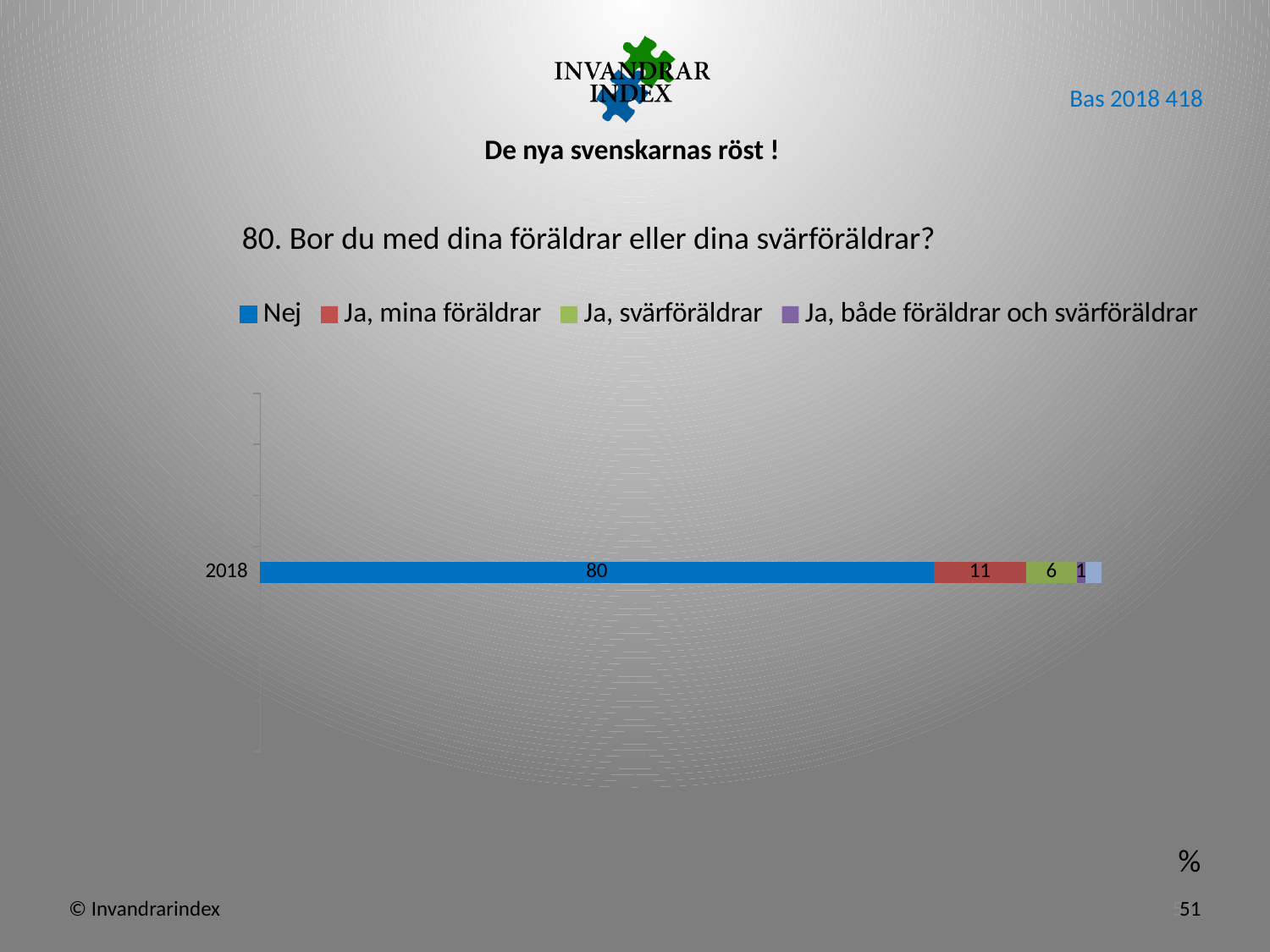
How many series does the legend list? 4 Which series has the highest value in 2018? Nej What is the value for "Ja, svärföräldrar" in 2018? 6 Which is larger in 2018, "Ja, mina föräldrar" or "Ja, svärföräldrar"? Ja, mina föräldrar What is the value for "Ja, både föräldrar och svärföräldrar" in 2018? 1 What is the difference between the values for "Nej" and "Ja, mina föräldrar" in 2018? 69 What is the value for "Nej" in 2018? 80 Which series has the lowest value in 2018? Ja, både föräldrar och svärföräldrar What is the difference between the values for "Ja, mina föräldrar" and "Ja, svärföräldrar" in 2018? 5 What kind of chart is shown on the slide? bar chart What is the value for "Ja, mina föräldrar" in 2018? 11 What is the title of the chart? 80. Bor du med dina föräldrar eller dina svärföräldrar?